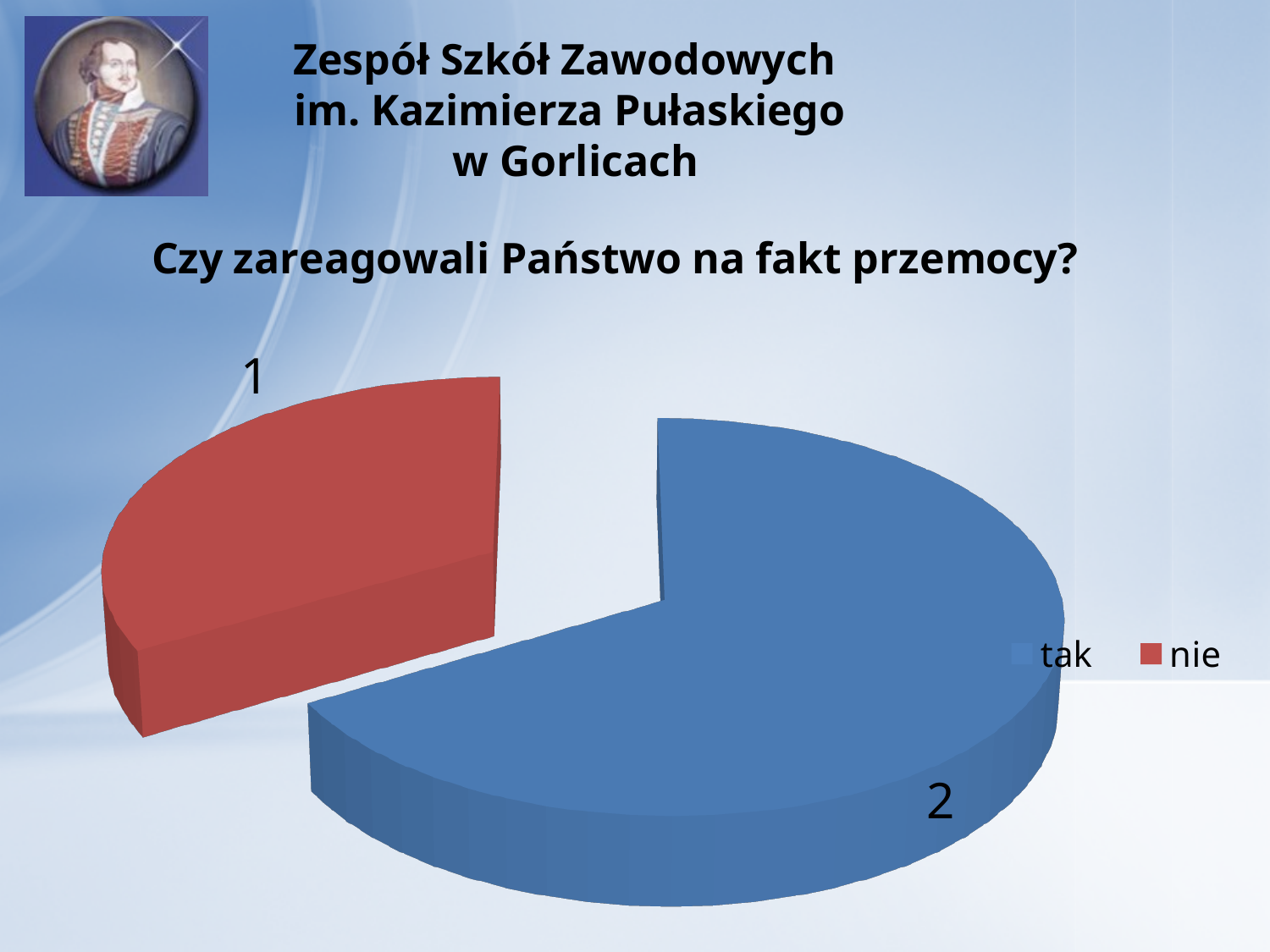
What is the value shown for the "nie" slice? 1 How many slices does the pie chart have? 2 What colour is the "nie" slice? red What question is the chart titled with? Czy zareagowali Państwo na fakt przemocy? Which category has the smallest slice of the pie? nie What is the value shown for the "tak" slice? 2 Which is larger, the value for "tak" or the value for "nie"? tak What kind of chart is shown on the slide? pie chart What is the total of all the slice values in the pie chart? 3 How many entries does the legend list? 2 Which category has the largest slice of the pie? tak What is the difference between the values for "tak" and "nie"? 1